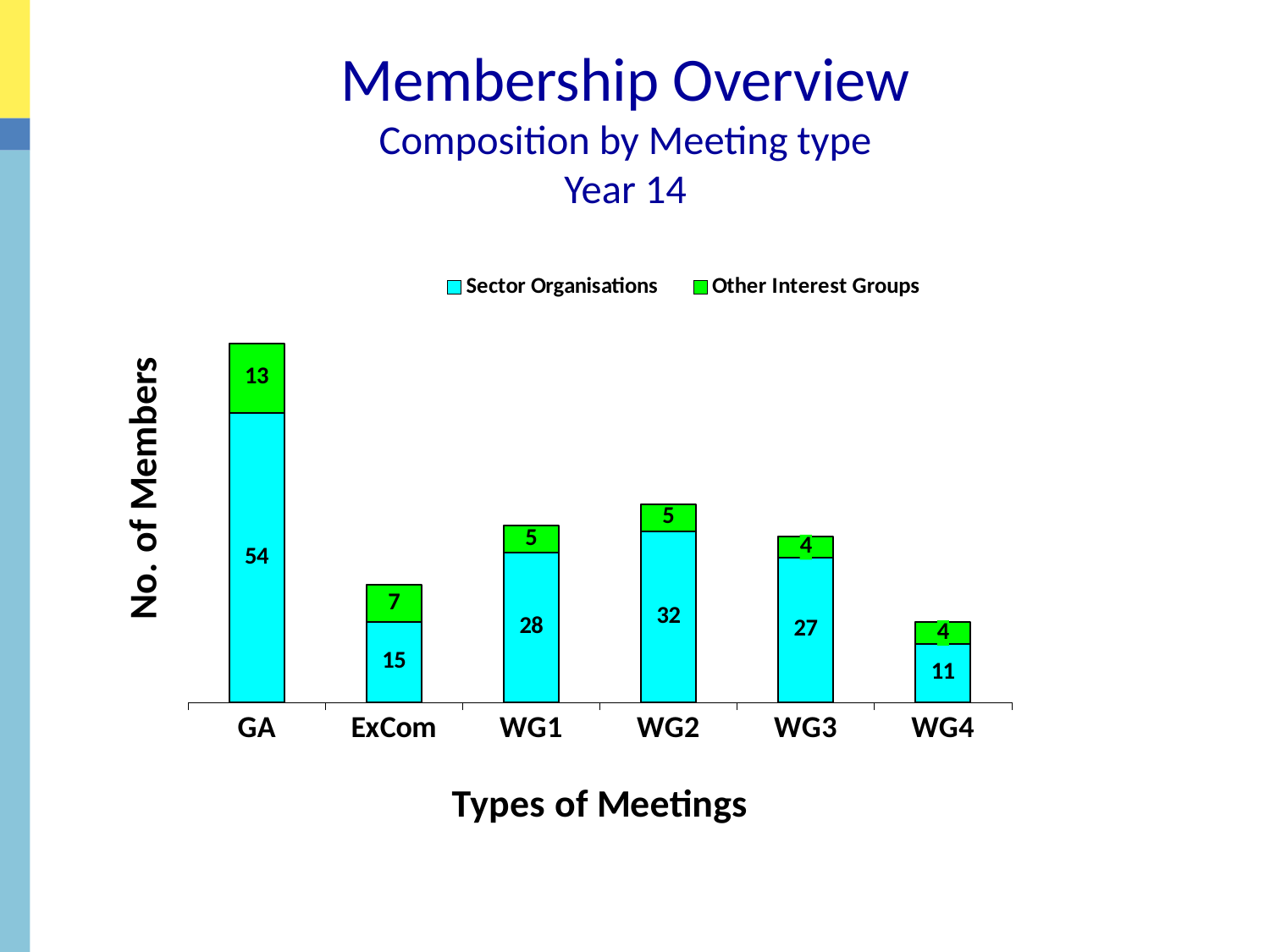
Which meeting type has the lowest Sector Organisations value? WG4 What is the Sector Organisations value for WG2? 32 What is the total number of members for the ExCom bar? 22 What is the Sector Organisations value for GA? 54 What is the label of the y axis? No. of Members Which meeting type has the highest Sector Organisations value? GA What is the Other Interest Groups value for ExCom? 7 How many meeting types are shown on the x axis? 6 What is the difference between the Sector Organisations values for WG1 and WG3? 1 How many series does the legend list? 2 What kind of chart is shown? Stacked bar chart Which is larger, the Other Interest Groups value for GA or for WG2? GA